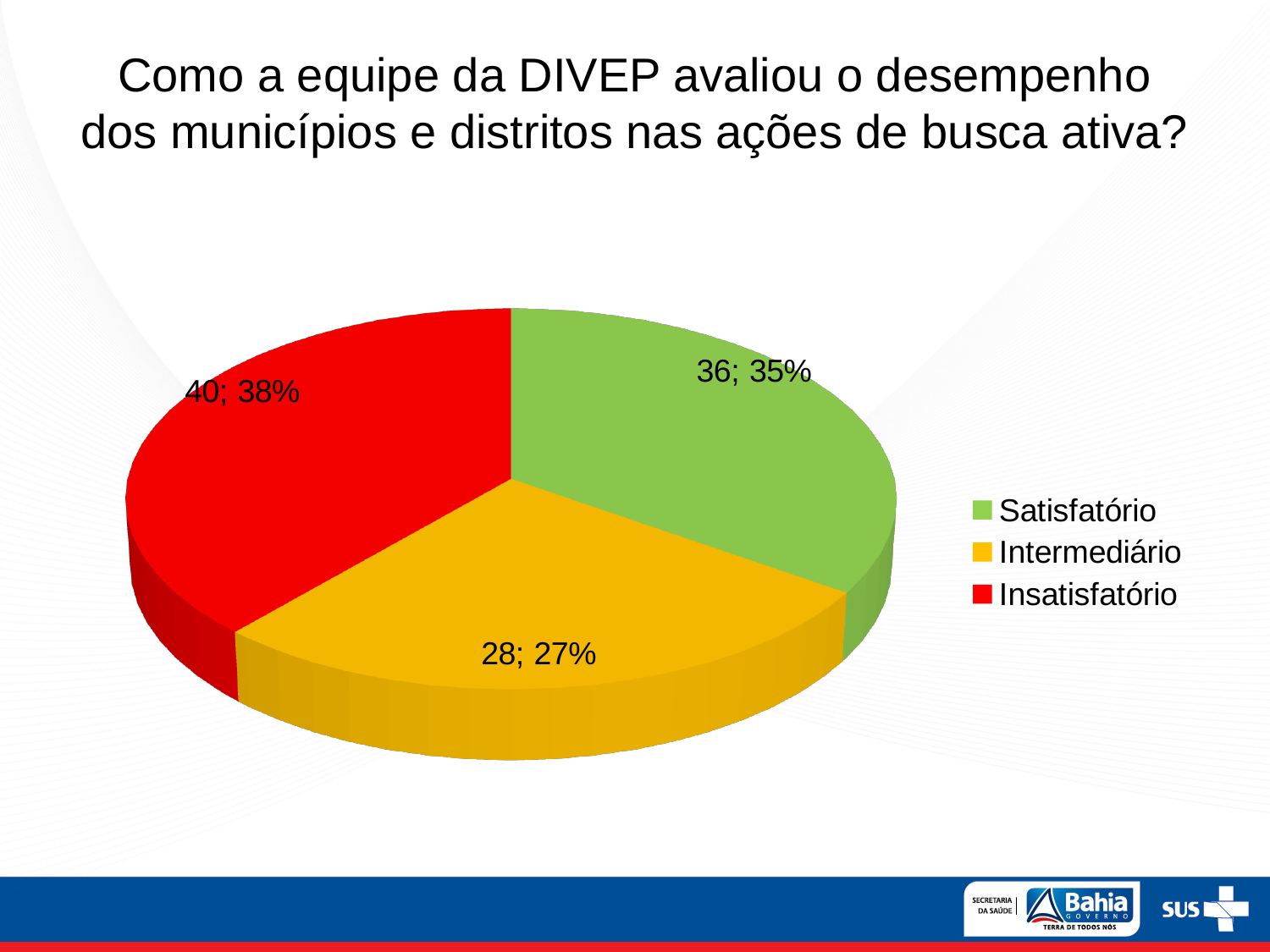
What kind of chart is shown on the slide? pie chart What is the count for Satisfatório? 36 What share of the pie does Intermediário represent? 27% What is the difference between the counts for Insatisfatório and Intermediário? 12 What share of the pie does Insatisfatório represent? 38% How many entries does the legend list? 3 Which category has the largest slice? Insatisfatório Which category has the smallest slice? Intermediário Which colour represents Satisfatório in the legend? green How many slices does the pie chart have? 3 What is the count for Insatisfatório? 40 What is the count for Intermediário? 28